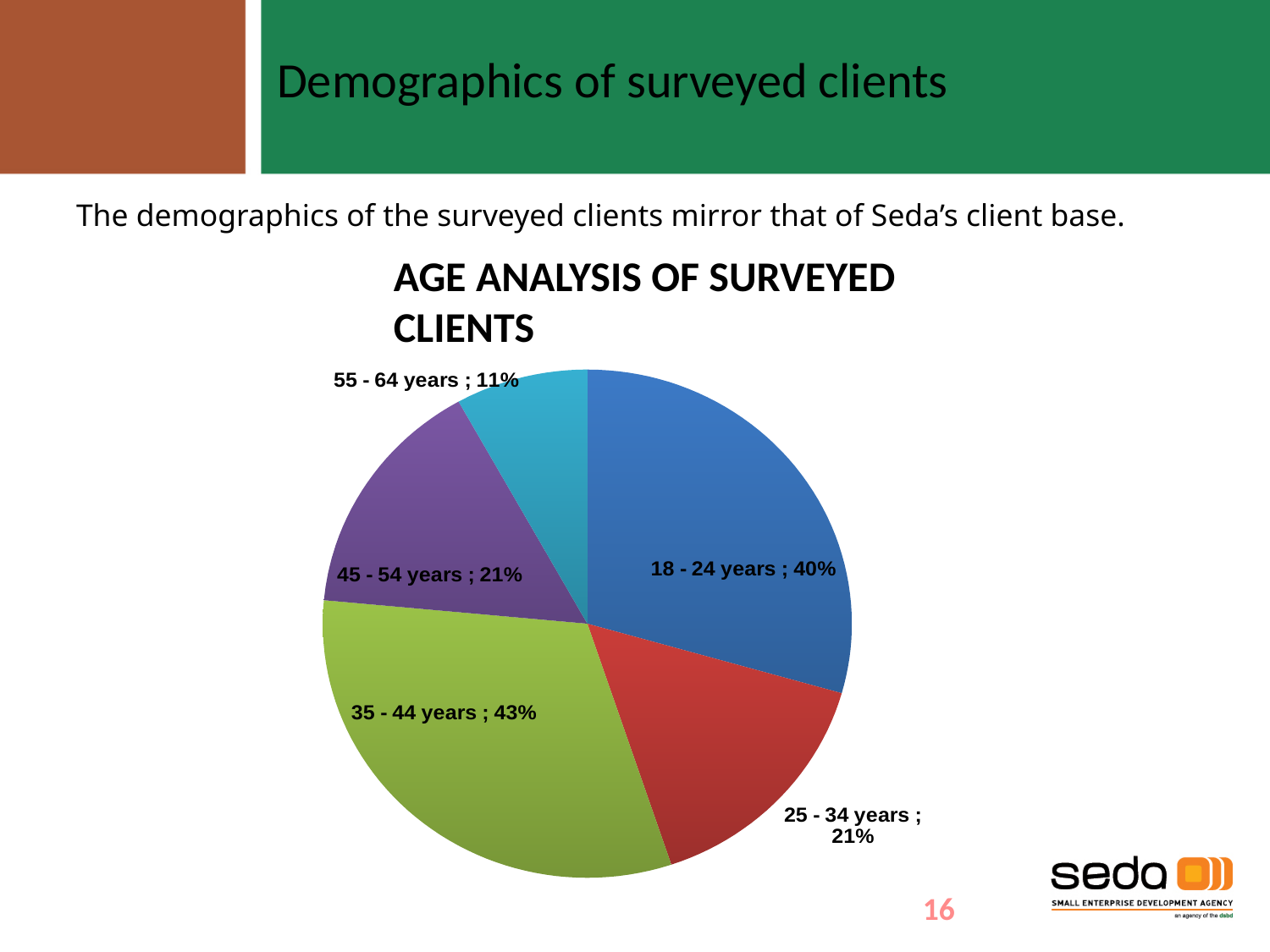
What type of chart is shown on the slide? Pie chart What percentage of surveyed clients are 45 - 54 years old? 21% Which is larger: the share for 18 - 24 years or the share for 55 - 64 years? 18 - 24 years What percentage of surveyed clients are 18 - 24 years old? 40% Which age group has the largest share of surveyed clients? 35 - 44 years What percentage of surveyed clients are 55 - 64 years old? 11% Which age group has the smallest share of surveyed clients? 55 - 64 years What percentage of surveyed clients are 35 - 44 years old? 43% What is the difference in percentage points between the 35 - 44 years share and the 18 - 24 years share? 3 percentage points What is the title of the chart? AGE ANALYSIS OF SURVEYED CLIENTS What share of the pie does the 25 - 34 years slice represent? 21% How many age categories are shown in the pie chart? 5